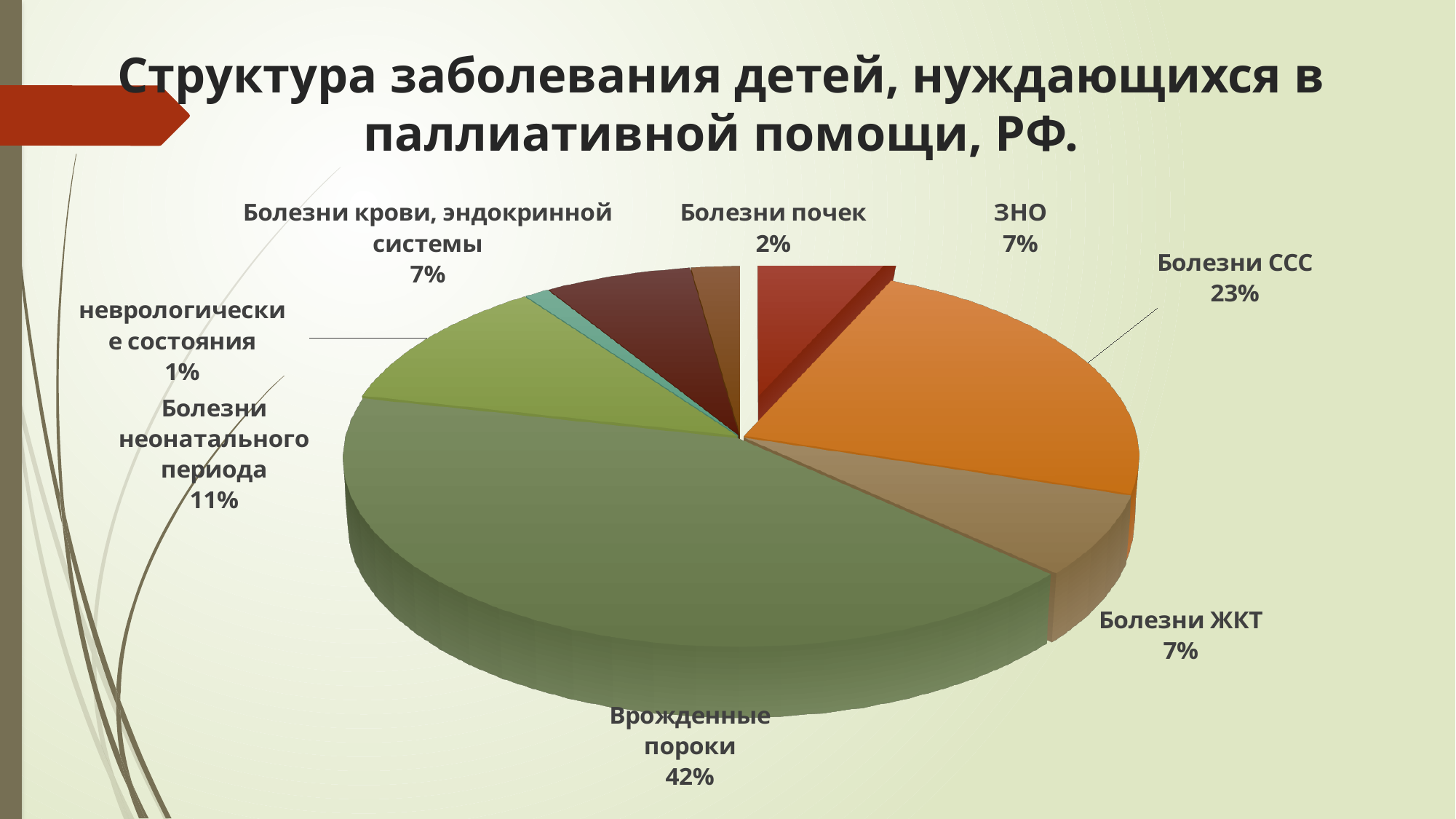
What share is shown for Болезни почек? 2% How many categories share the value 7%? 3 What is the title of the chart on the slide? Структура заболевания детей, нуждающихся в паллиативной помощи, РФ. Which is larger: the share for Болезни неонатального периода or the share for ЗНО? Болезни неонатального периода Which category has the largest share of the pie? Врожденные пороки What is the difference in percentage points between Врожденные пороки and Болезни ССС? 19 What type of chart is shown on the slide? Pie chart What share of the pie is labelled for Врожденные пороки? 42% What share is shown for Болезни ССС? 23% What share is shown for Болезни неонатального периода? 11% How many categories are shown in the pie chart? 8 Which category has the smallest share of the pie? неврологические состояния